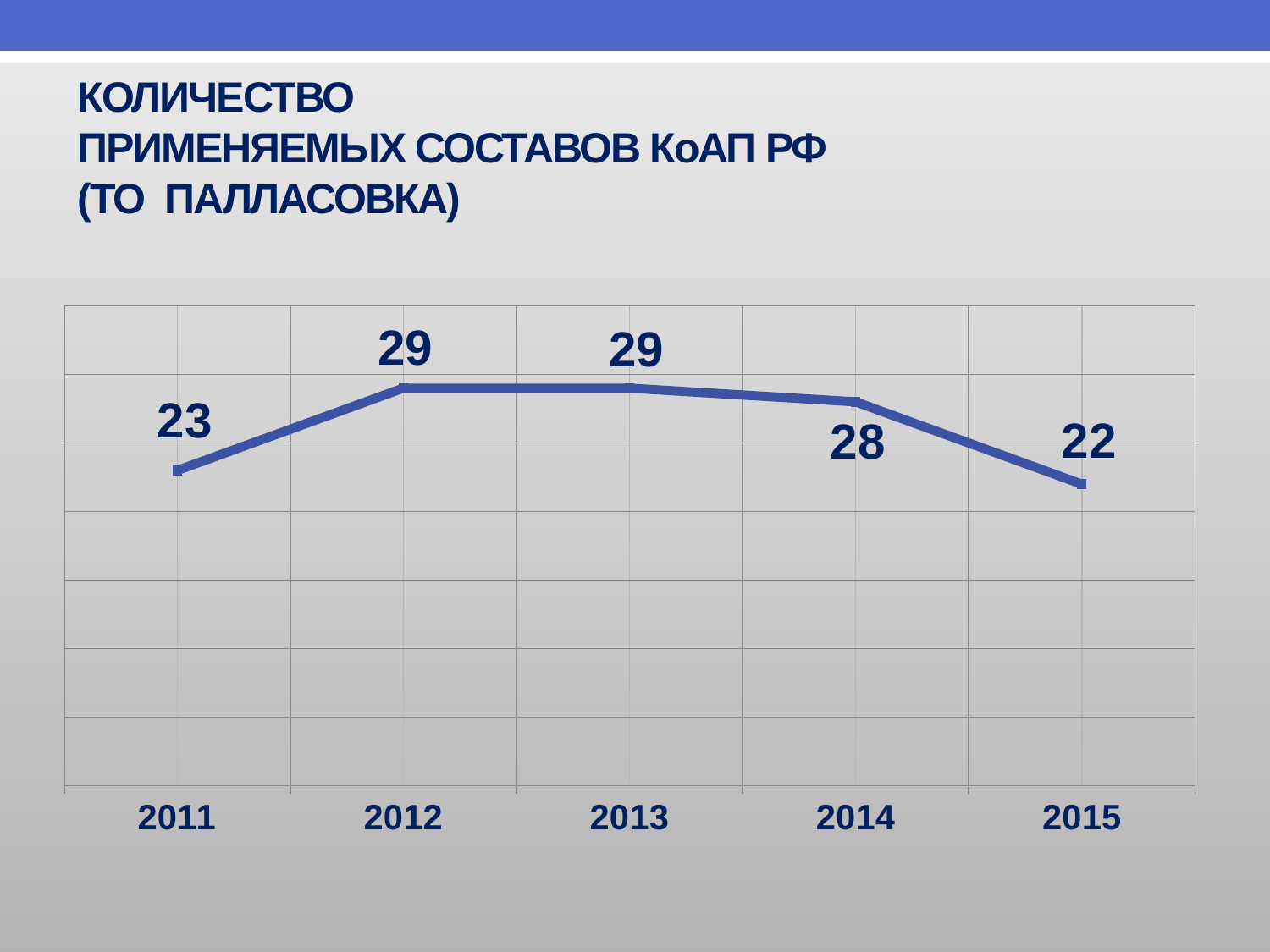
Which two years share the same highest value of 29? 2012 and 2013 How many years are plotted on the x axis? 5 What is the difference between the values for 2012 and 2011? 6 What is the difference between the values for 2014 and 2015? 6 What is the value for 2015? 22 What kind of chart is shown on the slide? line chart Which year has the lowest value? 2015 Do the values rise or fall from 2013 to 2015? fall What is the value for 2014? 28 What is the value for 2011? 23 Which is larger, the value for 2011 or the value for 2015? 2011 What is the value for 2012? 29